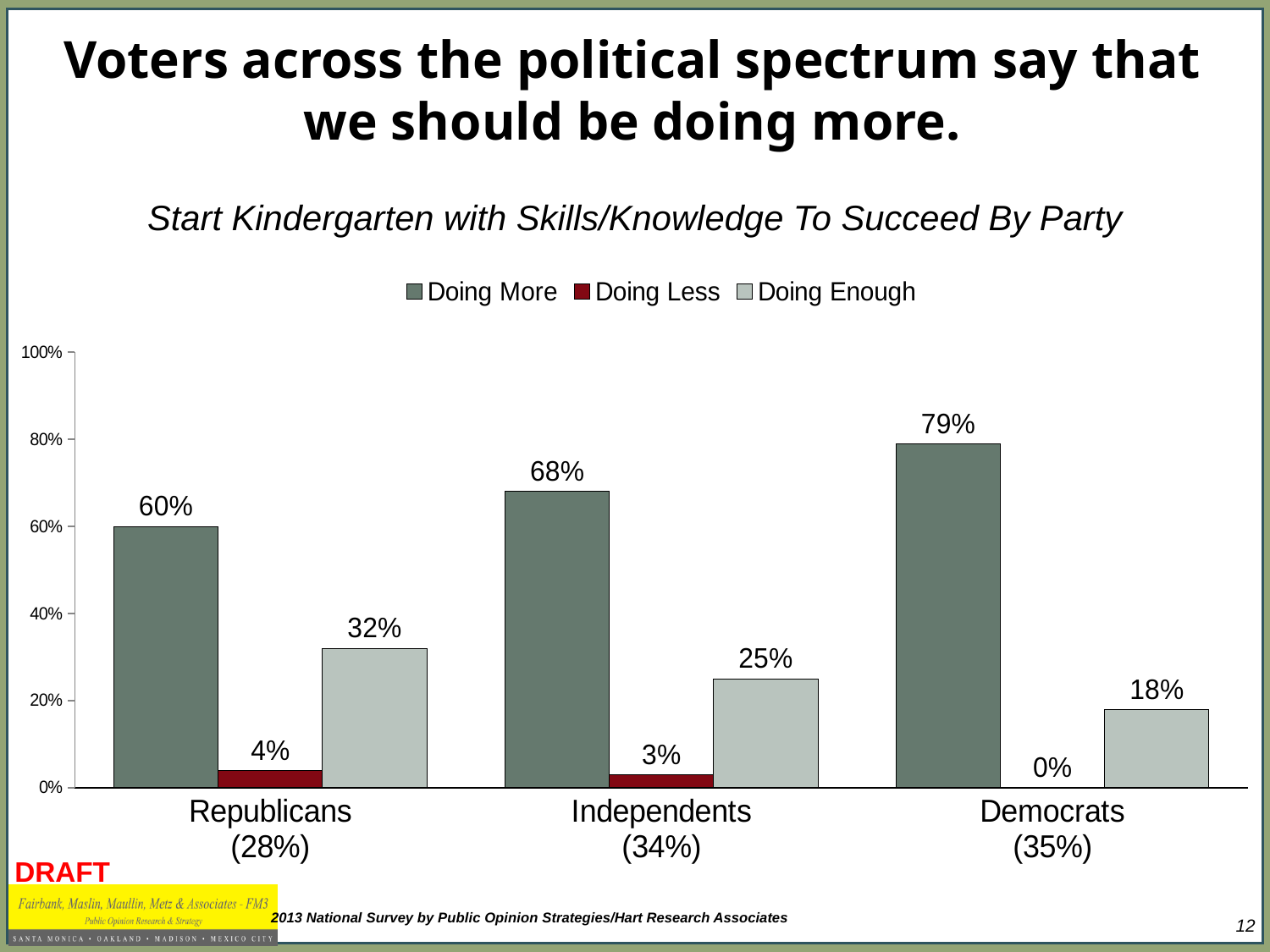
Which party has the highest "Doing More" value? Democrats Which party has the lowest "Doing Enough" value? Democrats What kind of chart is shown on the slide? Bar chart What percentage of Independents say we are "Doing Less"? 3% How many series does the legend list? 3 What percentage of Republicans say we are "Doing More"? 60% What is the difference between the "Doing More" values for Democrats and Republicans? 19% What percentage of Democrats say we are "Doing Enough"? 18% Which is larger: the "Doing Enough" value for Republicans or for Independents? Republicans Do the "Doing More" values rise or fall moving from Republicans to Democrats along the x axis? Rise How many party categories are shown on the x axis? 3 What is the subtitle of the chart? Start Kindergarten with Skills/Knowledge To Succeed By Party